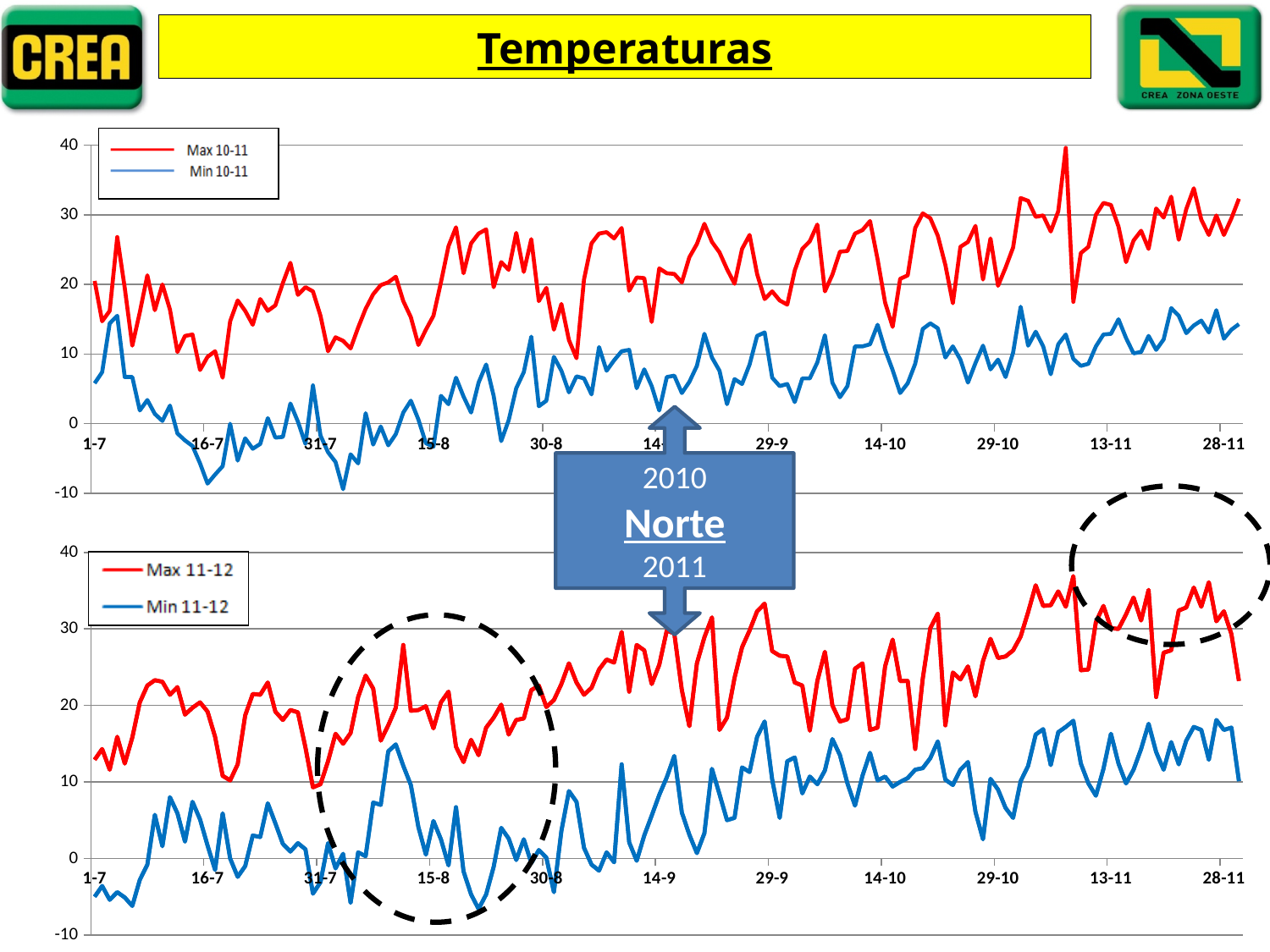
In the top chart, which series is plotted in red? Max 10-11 How many date labels are shown on the x axis of the bottom chart? 11 In the top chart, is the lowest value of the Min 10-11 series greater or less than 0? less In the bottom chart, is the value of Min 11-12 at 1-7 greater or less than 0? less In the top chart, which series has higher values throughout, Max 10-11 or Min 10-11? Max 10-11 In the bottom chart, do the Max 11-12 values generally rise or fall from 1-7 to 28-11? rise What kind of chart is the top chart (Max 10-11 / Min 10-11)? line chart How many series does the legend of the top chart list? 2 In the top chart, do the Min 10-11 values generally rise or fall from 1-7 to 28-11? rise What are the two series named in the legend of the bottom chart? Max 11-12 and Min 11-12 In the bottom chart, is the highest value of the Max 11-12 series greater or less than 30? greater